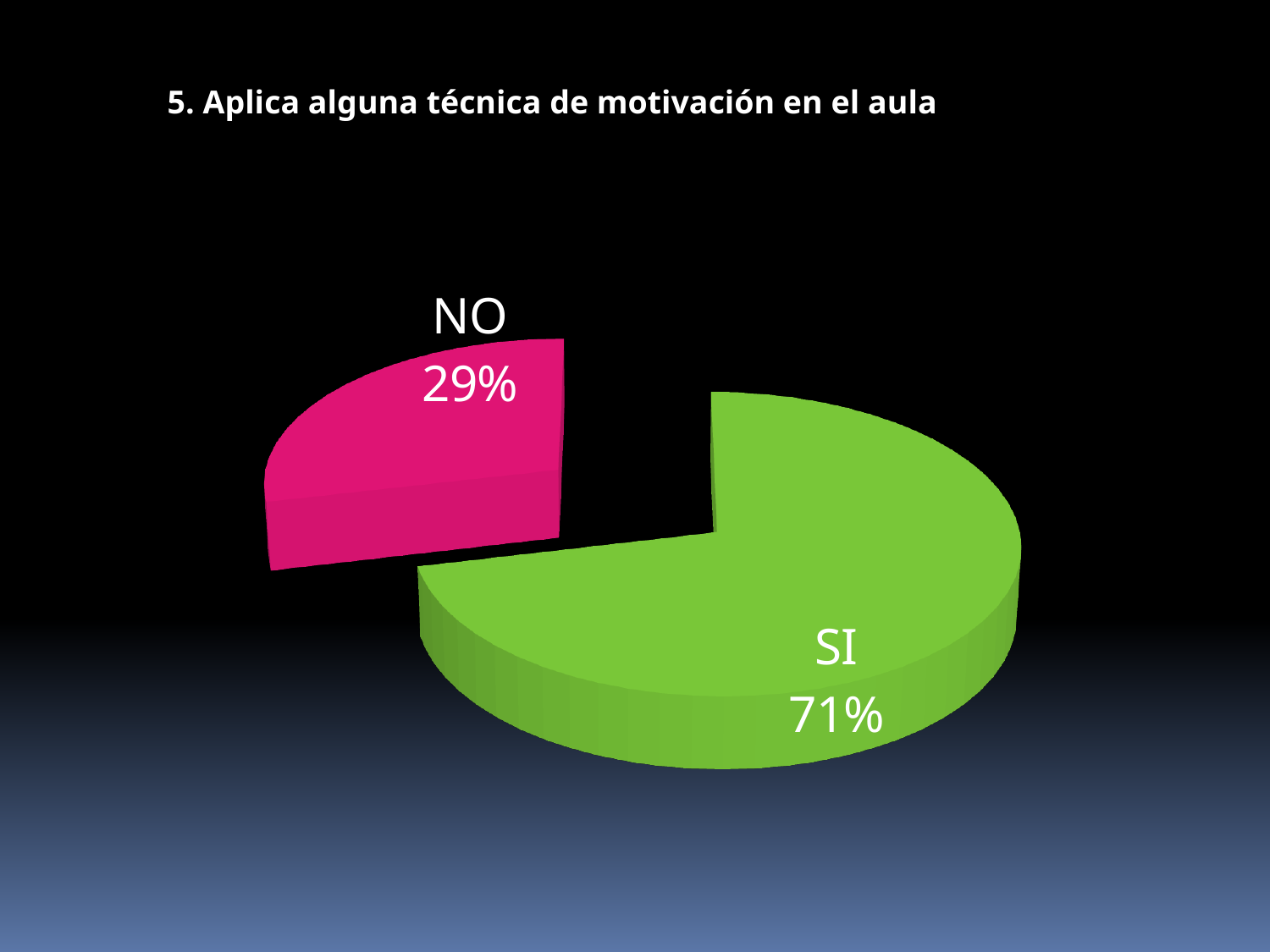
What share of the pie does the NO slice represent? 29% Which slice is larger, SI or NO? SI What kind of chart is shown on the slide? Pie chart What share of the pie does the SI slice represent? 71% How many slices does the pie chart have? 2 Which slice is the largest in the pie chart? SI What colour is the NO slice? Pink What is the title of the chart? 5. Aplica alguna técnica de motivación en el aula Which slice is the smallest in the pie chart? NO What is the difference in percentage points between the SI and NO slices? 42